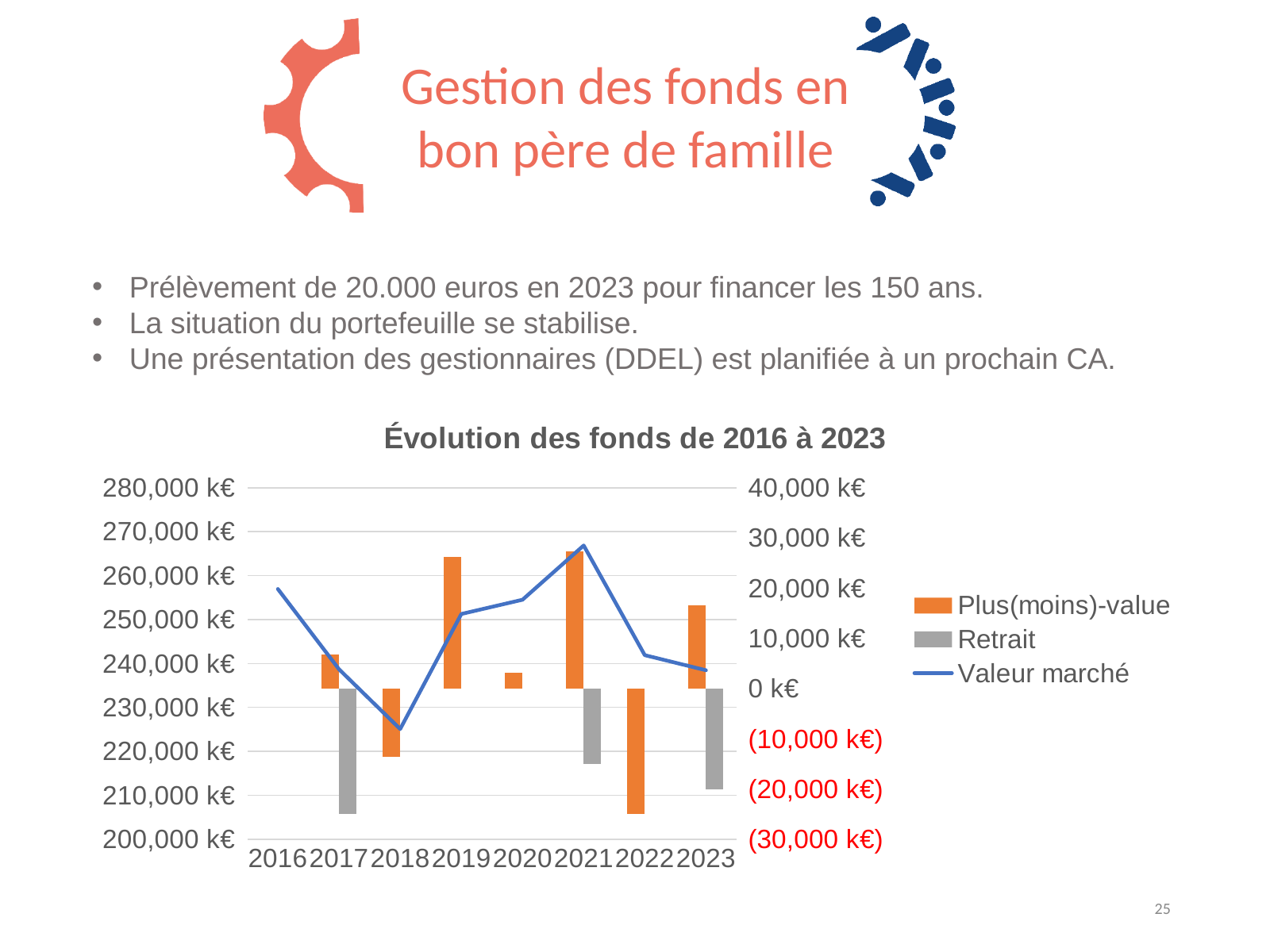
Which is higher on the 'Valeur marché' line, 2021 or 2022? 2021 Is the 'Plus(moins)-value' bar for 2022 greater or less than 0 k€? less Is the 'Plus(moins)-value' bar for 2019 greater or less than 10,000 k€? greater Which year has the lowest 'Plus(moins)-value' bar? 2022 How many series does the legend of the chart list? 3 Is the 'Valeur marché' value for 2016 greater or less than 250,000 k€? greater How many years are shown on the x axis of the chart? 8 What kind of chart is 'Évolution des fonds de 2016 à 2023'? A combined bar and line chart In which year is the 'Valeur marché' line at its highest? 2021 Does the 'Valeur marché' line rise or fall from 2021 to 2023? It falls In which year is the 'Valeur marché' line at its lowest? 2018